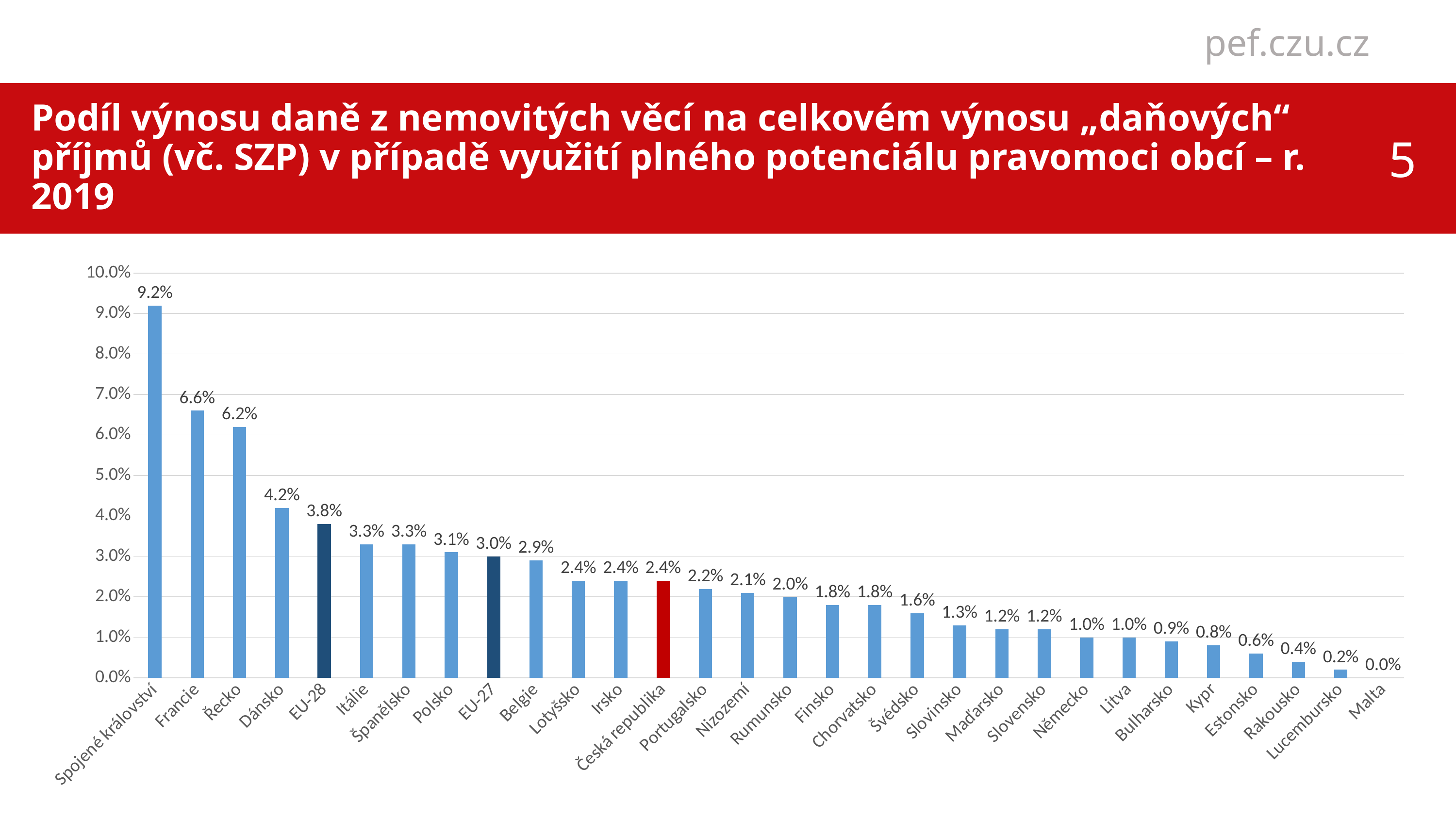
What is the value for Německo? 1.0% What is the value for EU-28? 3.8% How many categories are shown on the x axis? 30 What is the value for Česká republika? 2.4% Which is larger, the value for Dánsko or the value for Itálie? Dánsko What is the difference between the values for Francie and Řecko? 0.4% What is the value for Spojené království? 9.2% Do the values rise or fall from left to right along the x axis? fall What kind of chart is shown on the slide? bar chart What is the difference between the values for EU-28 and EU-27? 0.8% Which category has the highest value? Spojené království Which category has the lowest value? Malta